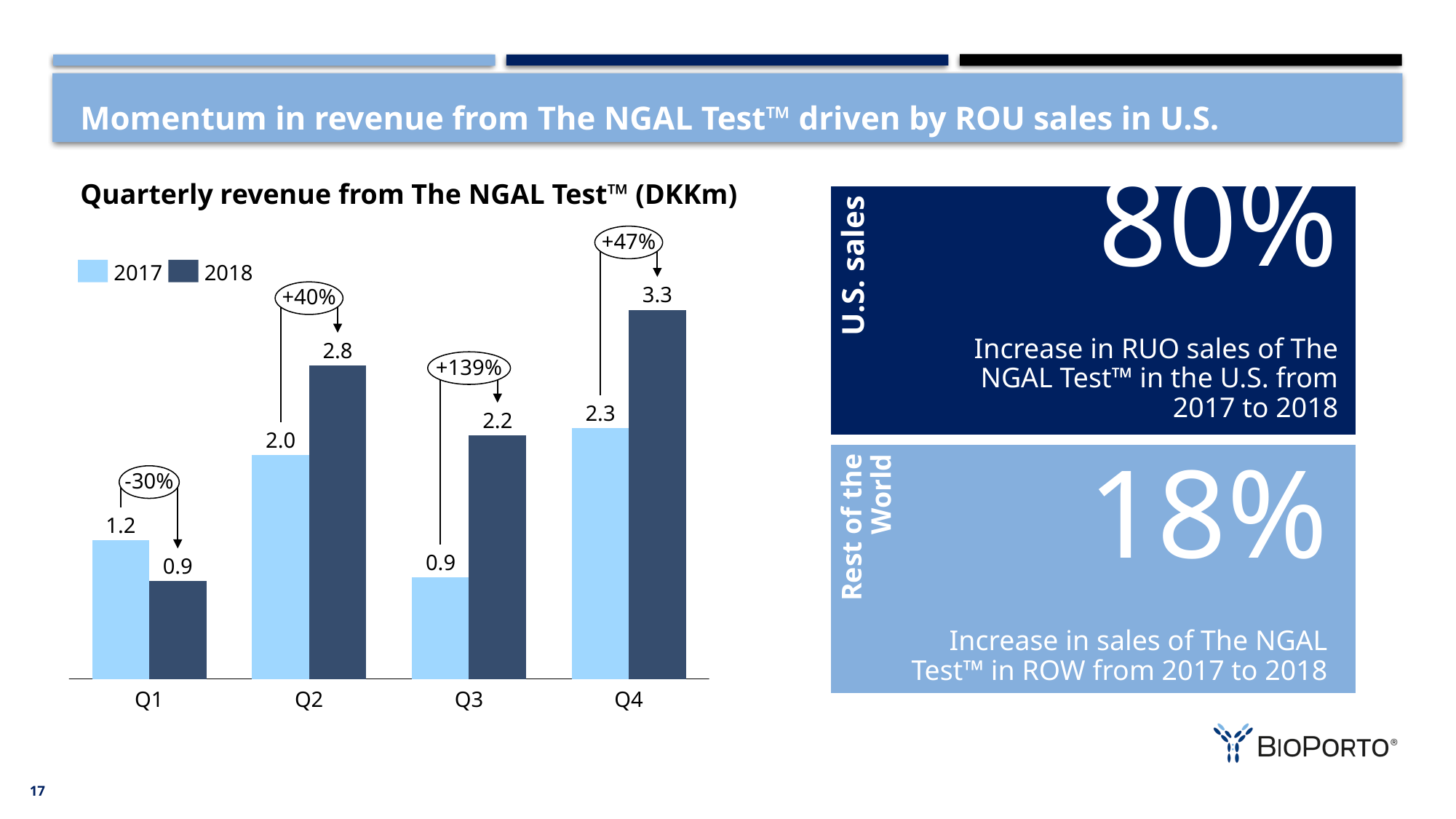
What is the difference between the 2018 and 2017 revenue in Q4? 1.0 Which series is shown in the darker blue bars? 2018 Which quarter had the highest 2018 revenue from The NGAL Test? Q4 Which was larger in Q1: the 2017 revenue or the 2018 revenue? 2017 How many series does the chart legend list? 2 What percentage change is annotated for Q3 in the chart? +139% What was the quarterly revenue from The NGAL Test in Q2 2018? 2.8 Which quarter had the lowest 2017 revenue from The NGAL Test? Q3 What was the quarterly revenue from The NGAL Test in Q3 2017? 0.9 How many quarters are shown on the x axis of the chart? 4 What is the title of the chart? Quarterly revenue from The NGAL Test™ (DKKm) What kind of chart is used to show quarterly revenue from The NGAL Test? Bar chart